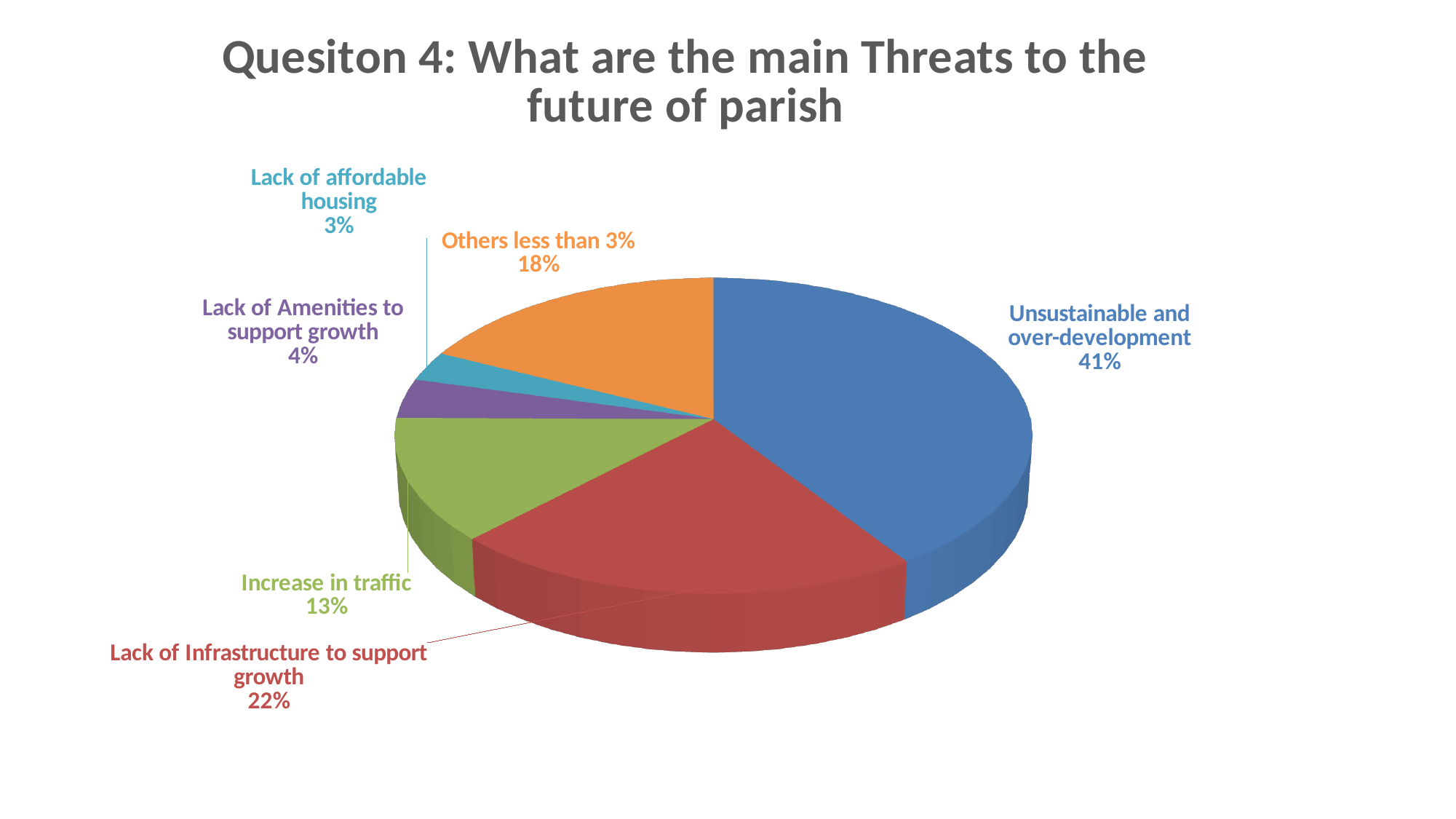
What share of the pie is 'Others less than 3%'? 18% What is the difference in percentage points between 'Unsustainable and over-development' and 'Lack of Infrastructure to support growth'? 19 What share of the pie is 'Increase in traffic'? 13% What kind of chart is shown on the slide? Pie chart How many slices does the pie chart have? 6 Which category has the smallest slice of the pie? Lack of affordable housing What share of the pie is 'Lack of affordable housing'? 3% Which category has the largest slice of the pie? Unsustainable and over-development Which is larger, 'Others less than 3%' or 'Increase in traffic'? Others less than 3% What is the title of the chart? Quesiton 4: What are the main Threats to the future of parish